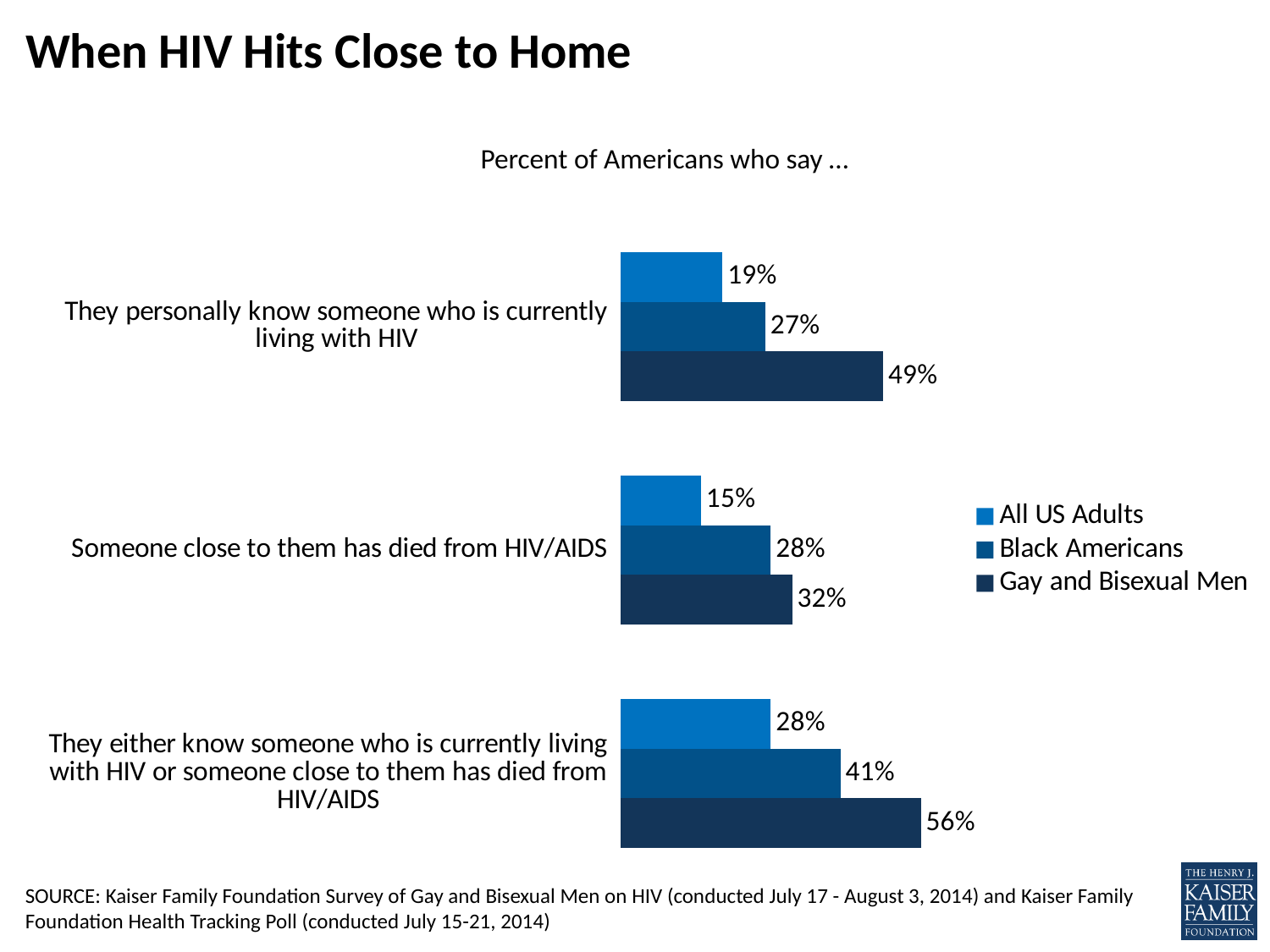
What is the difference between Black Americans and All US Adults for either knowing someone living with HIV or someone close to them having died from HIV/AIDS? 13 percentage points What percent of Gay and Bisexual Men say someone close to them has died from HIV/AIDS? 32% What kind of chart is shown on the slide? Bar chart What percent of All US Adults say they personally know someone who is currently living with HIV? 19% What is the difference between Gay and Bisexual Men and All US Adults for personally knowing someone currently living with HIV? 30 percentage points How many series does the legend list? 3 Which is larger: the Black Americans value for someone close to them having died from HIV/AIDS, or the All US Adults value for the same category? Black Americans Which group has the highest value for personally knowing someone who is currently living with HIV? Gay and Bisexual Men How many categories are shown on the chart? 3 Which group has the lowest value for someone close to them having died from HIV/AIDS? All US Adults What percent of Black Americans say they either know someone currently living with HIV or someone close to them has died from HIV/AIDS? 41% What is the subtitle shown above the chart? Percent of Americans who say …